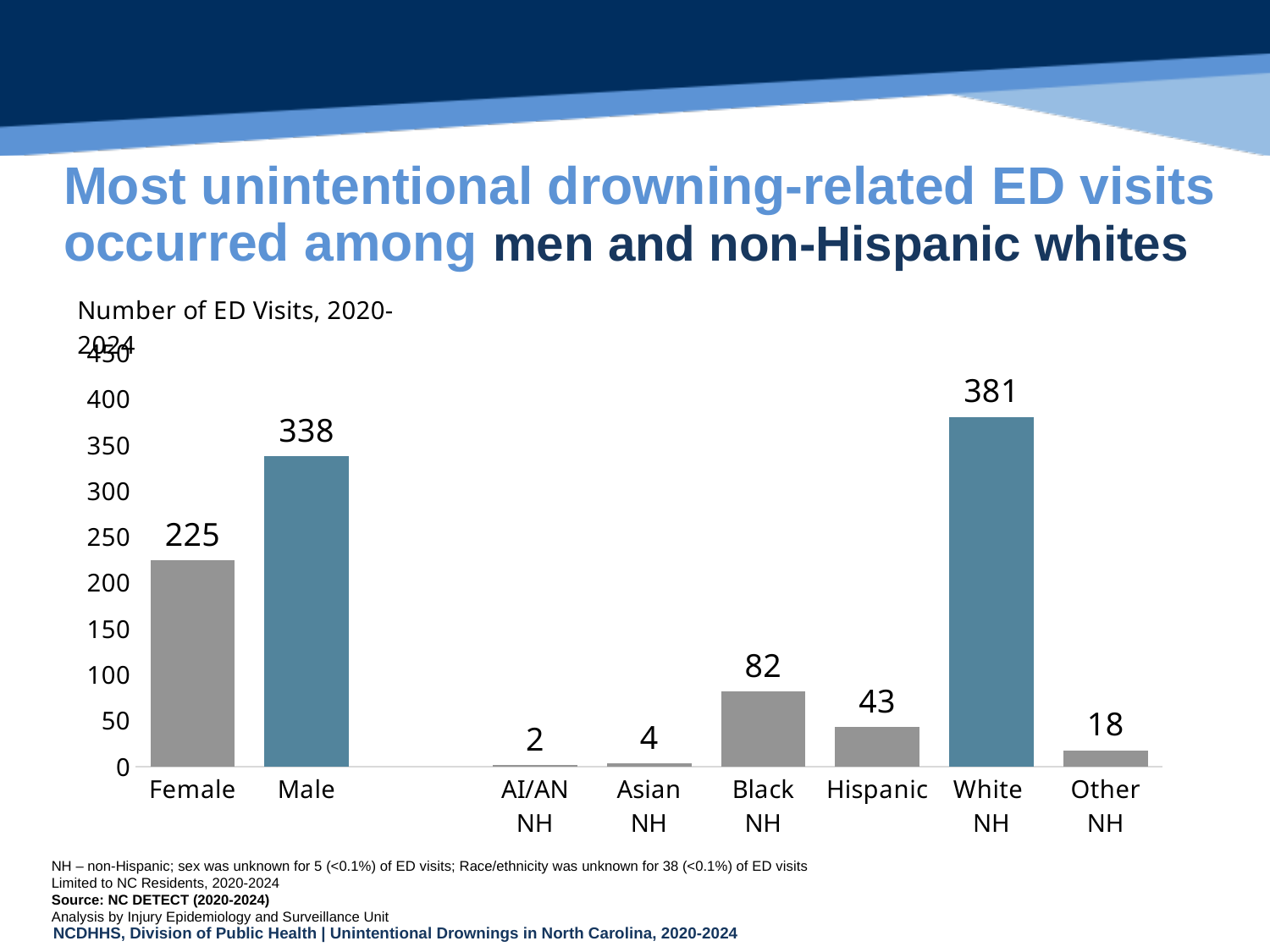
What kind of chart is shown on the slide? Bar chart Which is larger, the value for Asian NH or the value for Other NH? Other NH How many ED visits are shown for Male? 338 What is the value for Hispanic? 43 What is the title of the chart? Number of ED Visits, 2020-2024 How many categories are plotted on the chart? 8 What is the value for White NH? 381 Which category has the lowest number of ED visits? AI/AN NH What is the difference between the Male and Female values? 113 Which category has the highest number of ED visits? White NH What is the difference between the Black NH and Hispanic values? 39 How many ED visits are shown for Female? 225